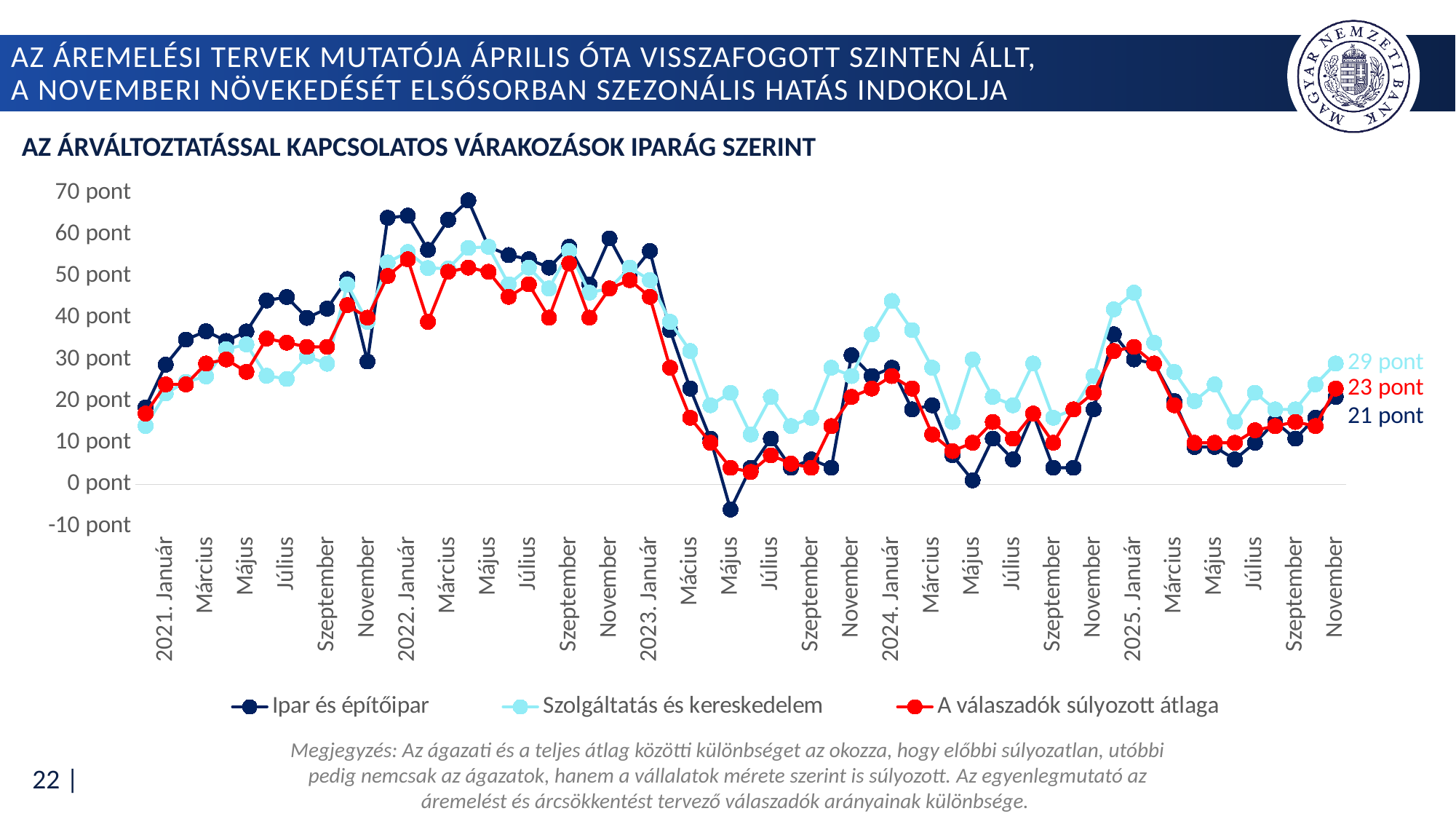
At the last point (2025 November), which series has the lowest value? Ipar és építőipar What is the value for Szolgáltatás és kereskedelem at the last point (2025 November)? 29 pont How many series does the legend list? 3 Is the value for Ipar és építőipar in 2023 Május greater or less than 0 pont? less What is the difference between the Szolgáltatás és kereskedelem and Ipar és építőipar values at the last point (2025 November)? 8 pont What kind of chart is shown on the slide? Line chart At the last point (2025 November), which is larger: A válaszadók súlyozott átlaga or Ipar és építőipar? A válaszadók súlyozott átlaga At the last point (2025 November), which series has the highest value? Szolgáltatás és kereskedelem What is the value for A válaszadók súlyozott átlaga at the last point (2025 November)? 23 pont Is the value for Ipar és építőipar in 2022 Május greater or less than 60 pont? less What is the value for Ipar és építőipar at the last point (2025 November)? 21 pont Does the Ipar és építőipar series rise or fall between 2023 Január and 2023 Május? Fall